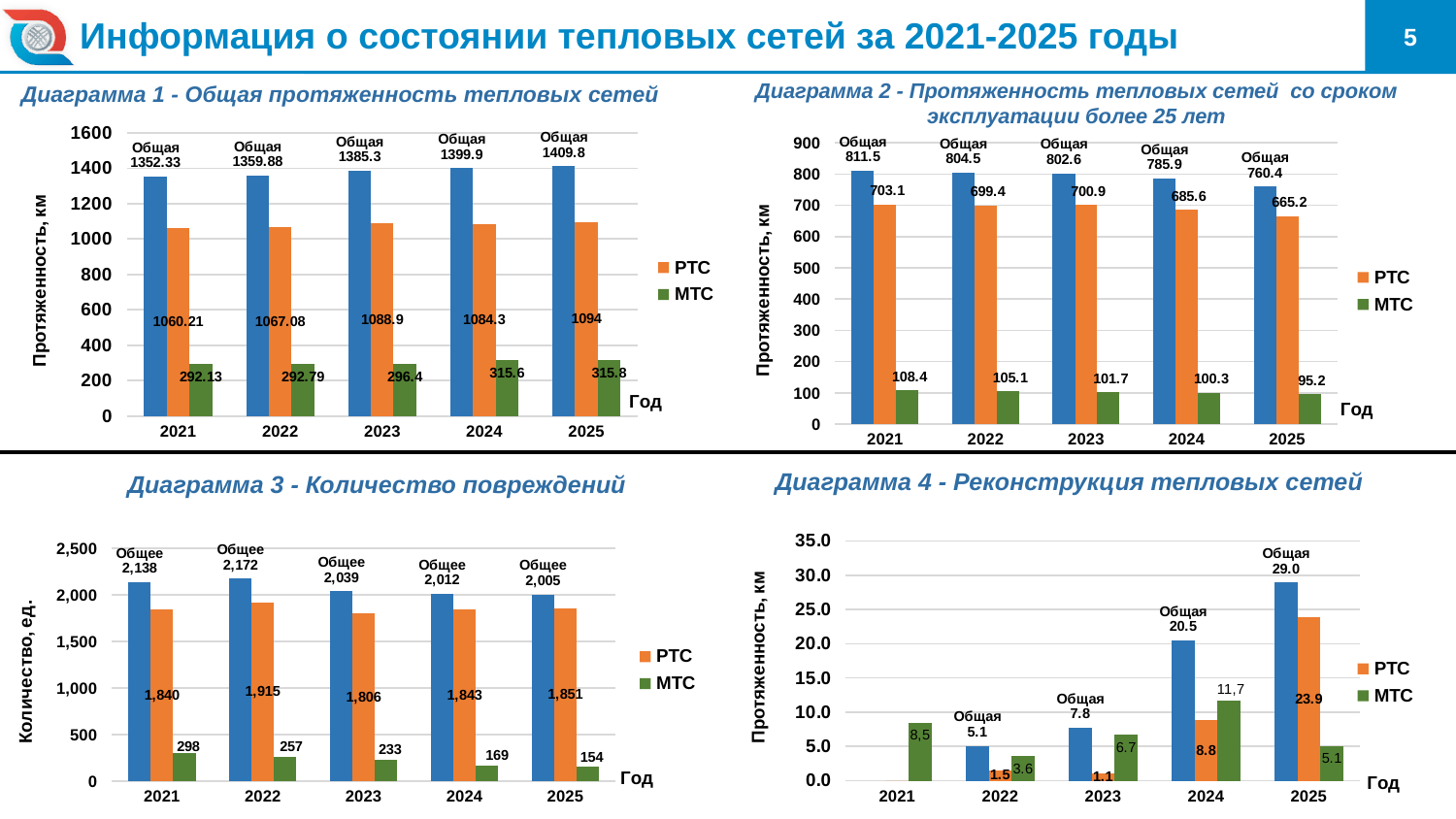
In Диаграмма 3 - Количество повреждений, what is the РТС value for 2022? 1,915 What type of chart is Диаграмма 4 - Реконструкция тепловых сетей? bar chart In Диаграмма 4 - Реконструкция тепловых сетей, how many series does the legend list? 2 In Диаграмма 3 - Количество повреждений, which is larger, the МТС value for 2021 or for 2025? 2021 In Диаграмма 1 - Общая протяженность тепловых сетей, in which year is the МТС value lowest? 2021 In Диаграмма 1 - Общая протяженность тепловых сетей, what is the total (Общая) length shown for 2025? 1409.8 In Диаграмма 4 - Реконструкция тепловых сетей, what is the РТС value for 2025? 23.9 In Диаграмма 1 - Общая протяженность тепловых сетей, what is the value for РТС in 2023? 1088.9 In Диаграмма 2 - Протяженность тепловых сетей со сроком эксплуатации более 25 лет, what is the МТС value for 2024? 100.3 In Диаграмма 2 - Протяженность тепловых сетей со сроком эксплуатации более 25 лет, what is the difference between the РТС values for 2021 and 2025? 37.9 In Диаграмма 2 - Протяженность тепловых сетей со сроком эксплуатации более 25 лет, does the total (Общая) value rise or fall from 2021 to 2025? fall In Диаграмма 3 - Количество повреждений, in which year is the total (Общее) number of damages highest? 2022